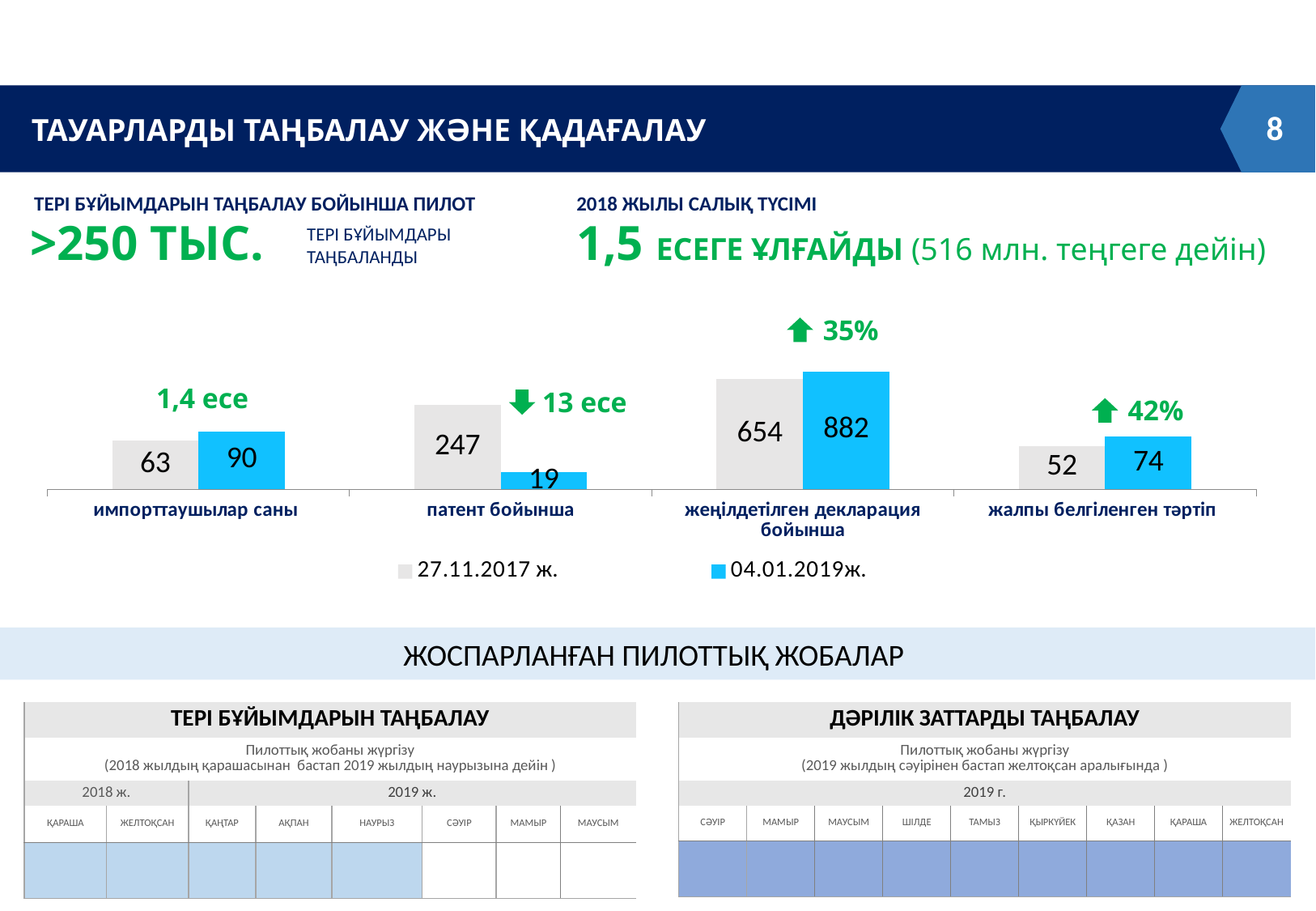
How many series does the chart legend list? 2 Which category has the highest value in the 04.01.2019ж. series? жеңілдетілген декларация бойынша Which category has the lowest value in the 04.01.2019ж. series? патент бойынша What is the difference between the 04.01.2019ж. and 27.11.2017 ж. values for 'жеңілдетілген декларация бойынша'? 228 For 'патент бойынша', which series has the larger value: 27.11.2017 ж. or 04.01.2019ж.? 27.11.2017 ж. What is the value for 'жеңілдетілген декларация бойынша' in the 04.01.2019ж. series? 882 What is the value for 'жалпы белгіленген тәртіп' in the 27.11.2017 ж. series? 52 What is the value for 'патент бойынша' in the 27.11.2017 ж. series? 247 How many categories are shown on the x axis of the chart? 4 What type of chart is shown on the slide? bar chart What percentage change is annotated above the 'жалпы белгіленген тәртіп' bars? 42% What is the value for 'импорттаушылар саны' in the 04.01.2019ж. series? 90